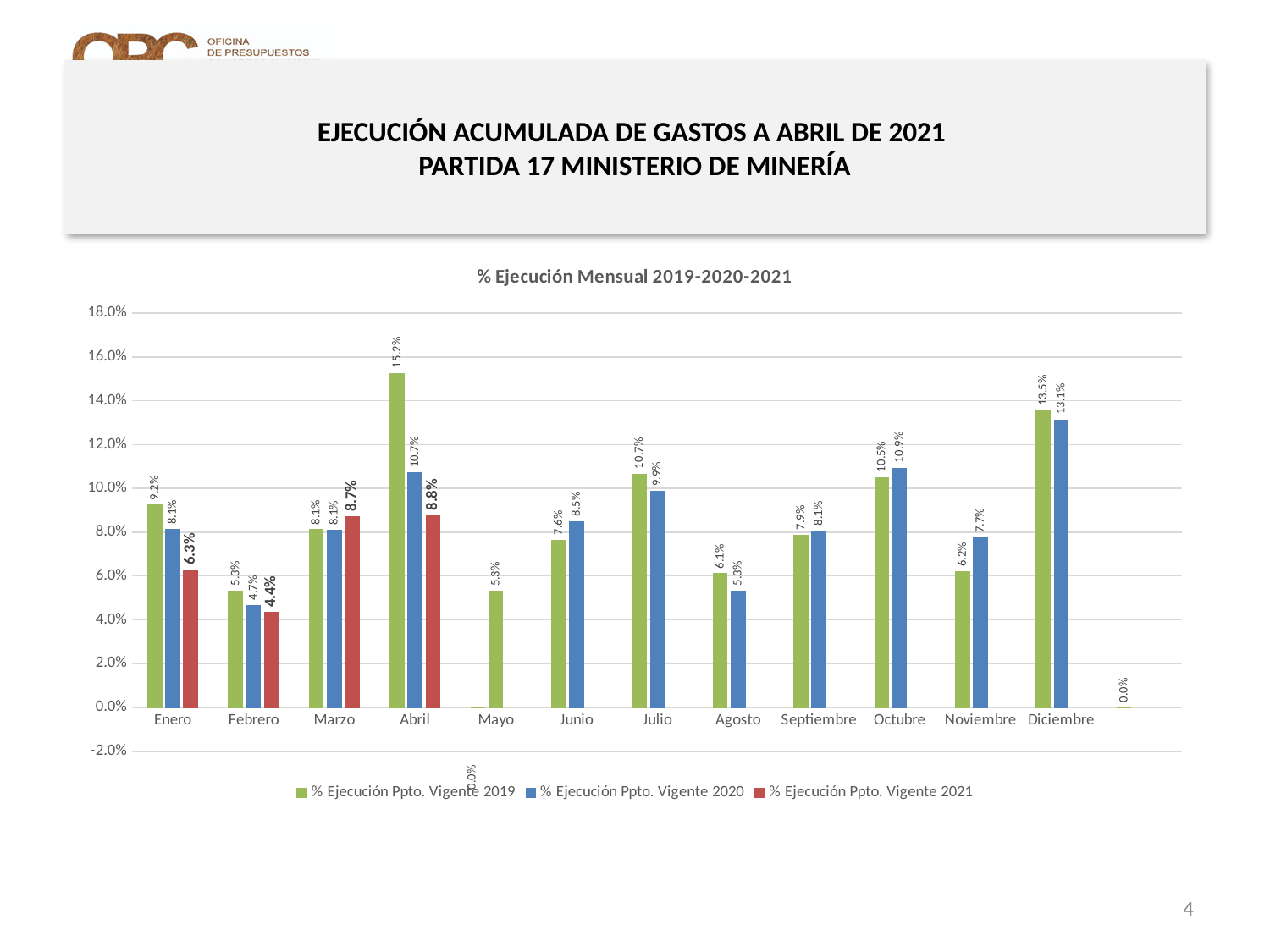
What kind of chart is shown on the slide? Bar chart What is the title of the chart? % Ejecución Mensual 2019-2020-2021 Which month has the highest value in the % Ejecución Ppto. Vigente 2019 series? Abril What is the value for Abril in the % Ejecución Ppto. Vigente 2019 series? 15.2% What is the value for Diciembre in the % Ejecución Ppto. Vigente 2020 series? 13.1% For Octubre, which series has the larger value, 2019 or 2020? % Ejecución Ppto. Vigente 2020 Which month has the lowest value in the % Ejecución Ppto. Vigente 2021 series? Febrero Is the value for Julio in the 2019 series greater or less than 10.0%? greater How many series does the legend list? 3 What is the value for Enero in the % Ejecución Ppto. Vigente 2021 series? 6.3% What is the value for Marzo in the % Ejecución Ppto. Vigente 2021 series? 8.7% What is the difference between the 2019 and 2020 values for Abril? 4.5 percentage points